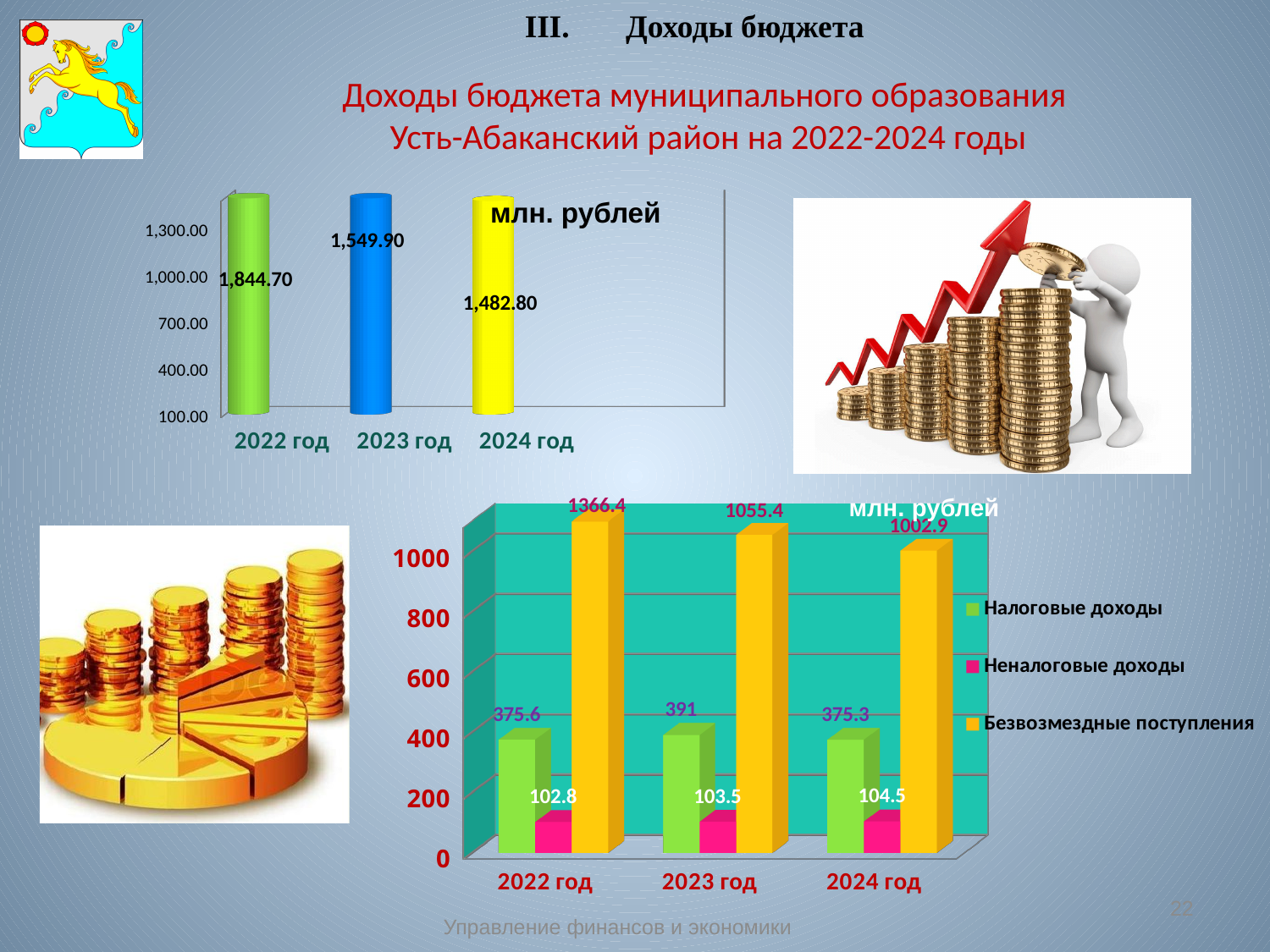
In the bottom chart, what is the value of Налоговые доходы for 2023 год? 391 In the top chart, what is the value for 2022 год? 1,844.70 In the top chart, what is the difference between the values for 2022 год and 2023 год? 294.80 What kind of chart is the bottom chart? bar chart In the bottom chart, how many series does the legend list? 3 In the top chart, do the values rise or fall from 2022 год to 2024 год? fall In the top chart, how many years are shown? 3 In the top chart, what is the value for 2024 год? 1,482.80 In the bottom chart, what is the value of Безвозмездные поступления for 2024 год? 1002.9 In the bottom chart, what is the difference between Безвозмездные поступления in 2022 год and 2023 год? 311 In the bottom chart, in which year are Безвозмездные поступления highest? 2022 год In the top chart, which year has the highest value? 2022 год